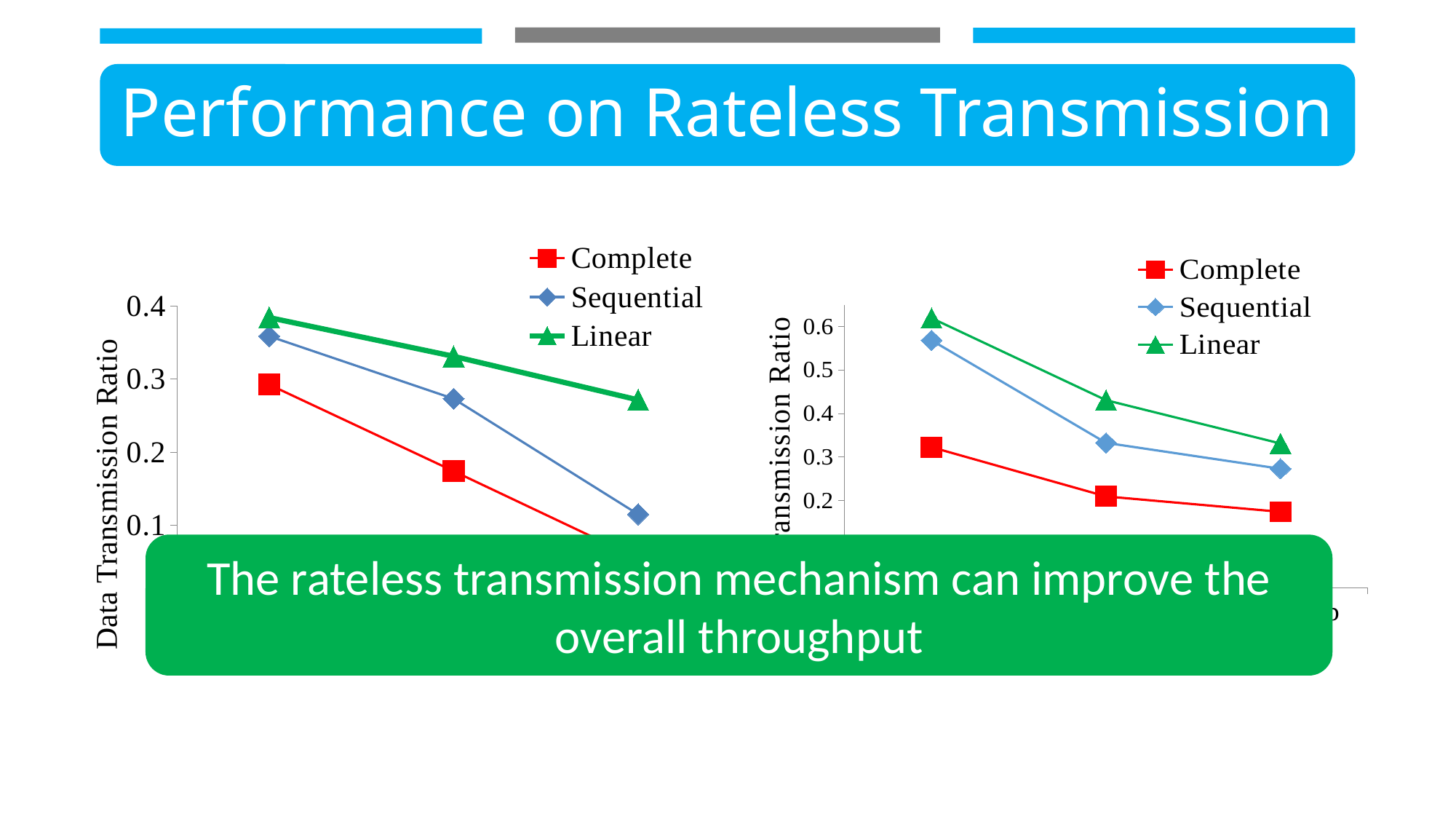
On the right chart, is the first point of the Complete series greater or less than 0.4? less What kind of chart is the left chart? line chart On the left chart, do the values of the Linear series rise or fall along the x axis? fall On the left chart, which series has the lowest values? Complete On the right chart, which series has the highest values? Linear On the left chart, which series has the highest values? Linear On the right chart, how many series does the legend list? 3 On the right chart, which series has the lowest values? Complete On the left chart, how many series does the legend list? 3 What is the y-axis title of the left chart? Data Transmission Ratio On the right chart, do the values of the Complete series rise or fall along the x axis? fall On the left chart, is the first point of the Linear series greater or less than 0.3? greater